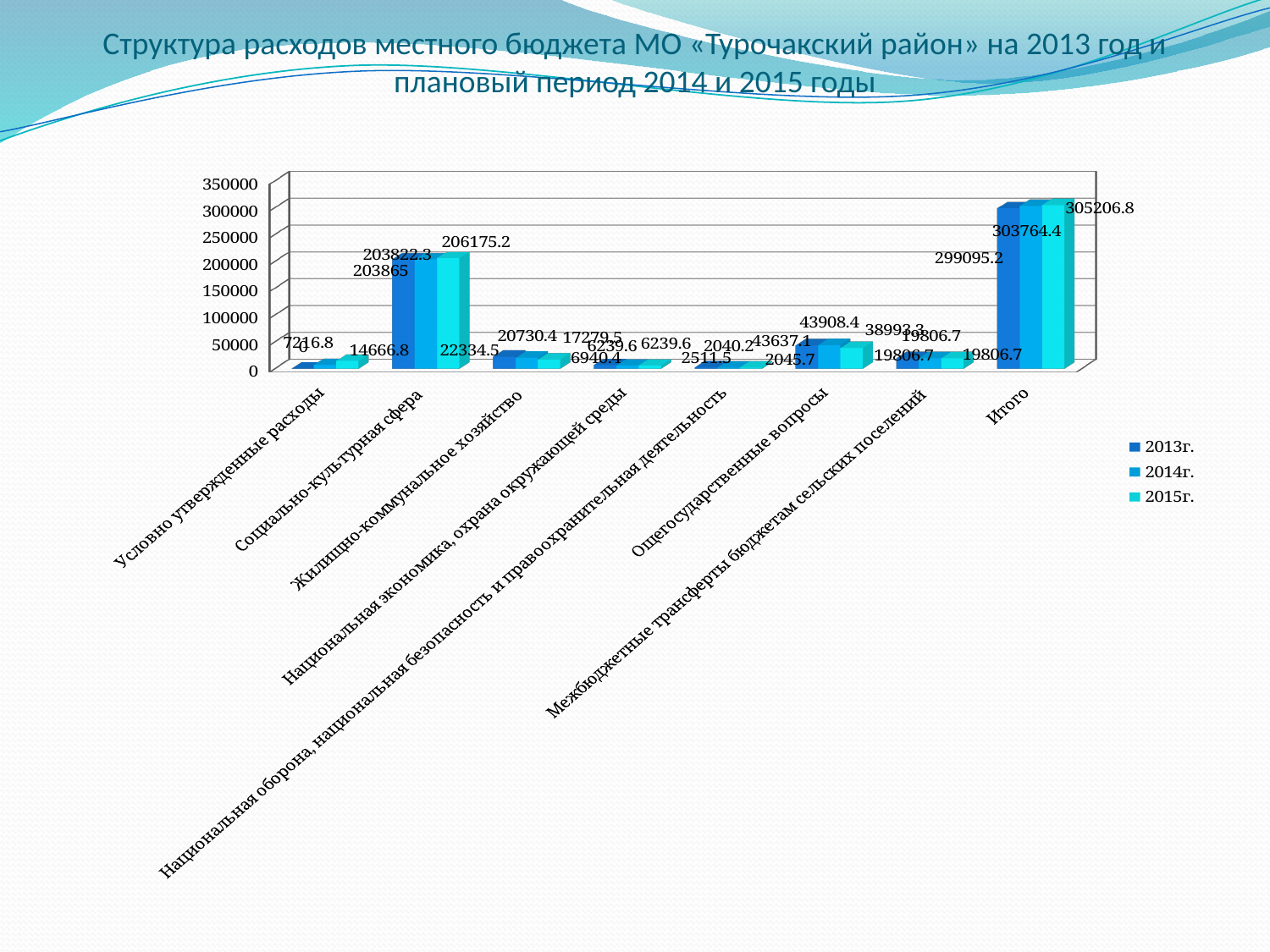
How many categories are shown on the x axis? 8 What kind of chart is shown on the slide? bar chart Do the values for Жилищно-коммунальное хозяйство rise or fall from 2013г. to 2015г.? fall What is the value for Итого in 2013г.? 299095.2 What is the value for Итого in 2015г.? 305206.8 What is the value for Жилищно-коммунальное хозяйство in 2013г.? 22334.5 How many series does the legend list? 3 What is the value for Социально-культурная сфера in 2015г.? 206175.2 By how much does the Итого value for 2015г. exceed the Итого value for 2013г.? 6111.6 For Общегосударственные вопросы, which year has the larger value, 2013г. or 2015г.? 2013г. What is the value for Межбюджетные трансферты бюджетам сельских поселений in 2014г.? 19806.7 Apart from Итого, which category has the tallest bars? Социально-культурная сфера